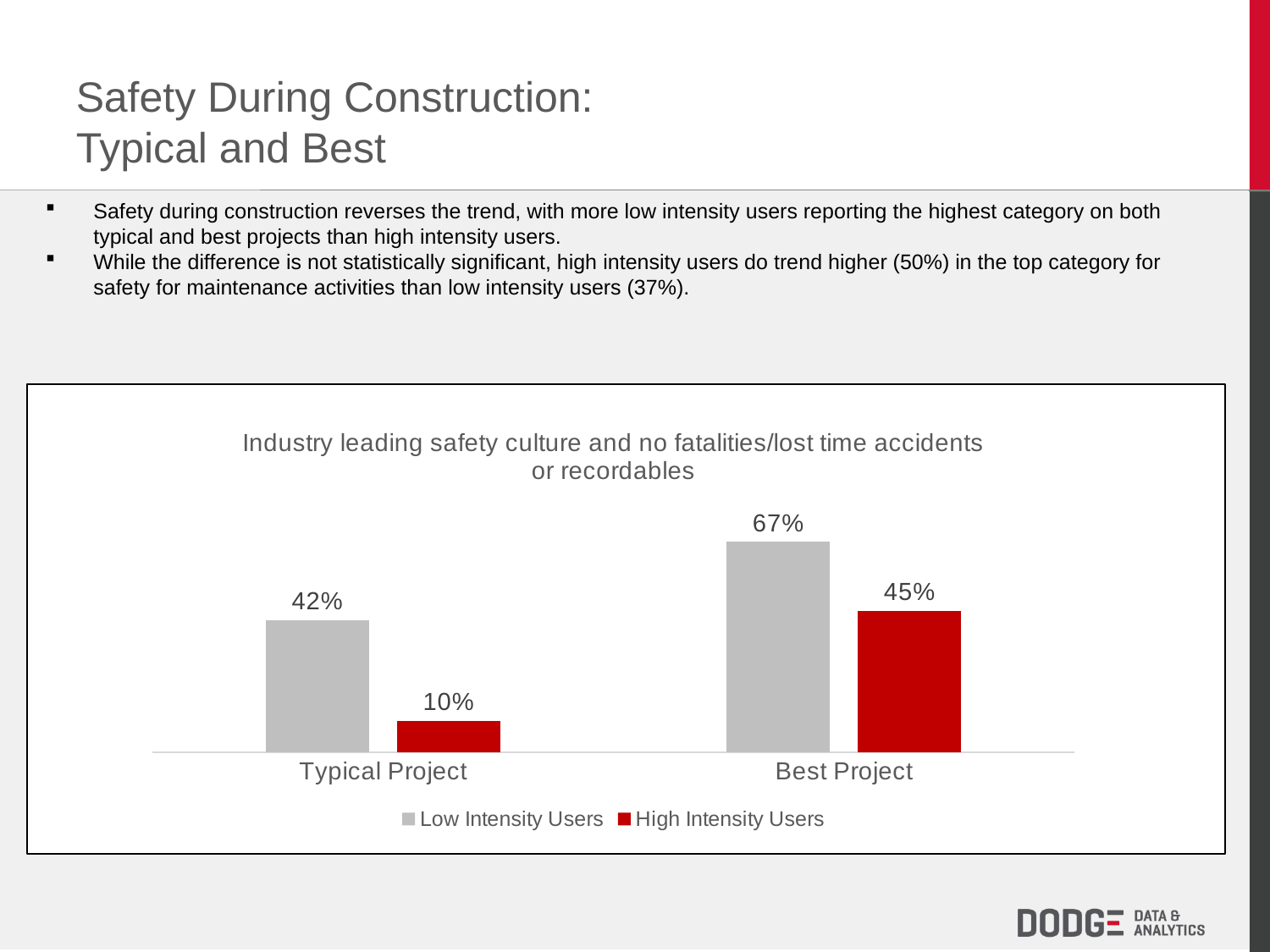
Which bar in the chart has the highest value? Low Intensity Users, Best Project Which bar in the chart has the lowest value? High Intensity Users, Typical Project What is the value for Low Intensity Users on a Typical Project? 42% What is the title of the chart? Industry leading safety culture and no fatalities/lost time accidents or recordables What is the difference between Low Intensity Users and High Intensity Users on a Typical Project? 32% What is the value for Low Intensity Users on a Best Project? 67% How many series does the legend list? 2 What is the value for High Intensity Users on a Typical Project? 10% What kind of chart is shown on the slide? Bar chart What is the difference between Low Intensity Users and High Intensity Users on a Best Project? 22% Which is larger for High Intensity Users: Typical Project or Best Project? Best Project What is the value for High Intensity Users on a Best Project? 45%